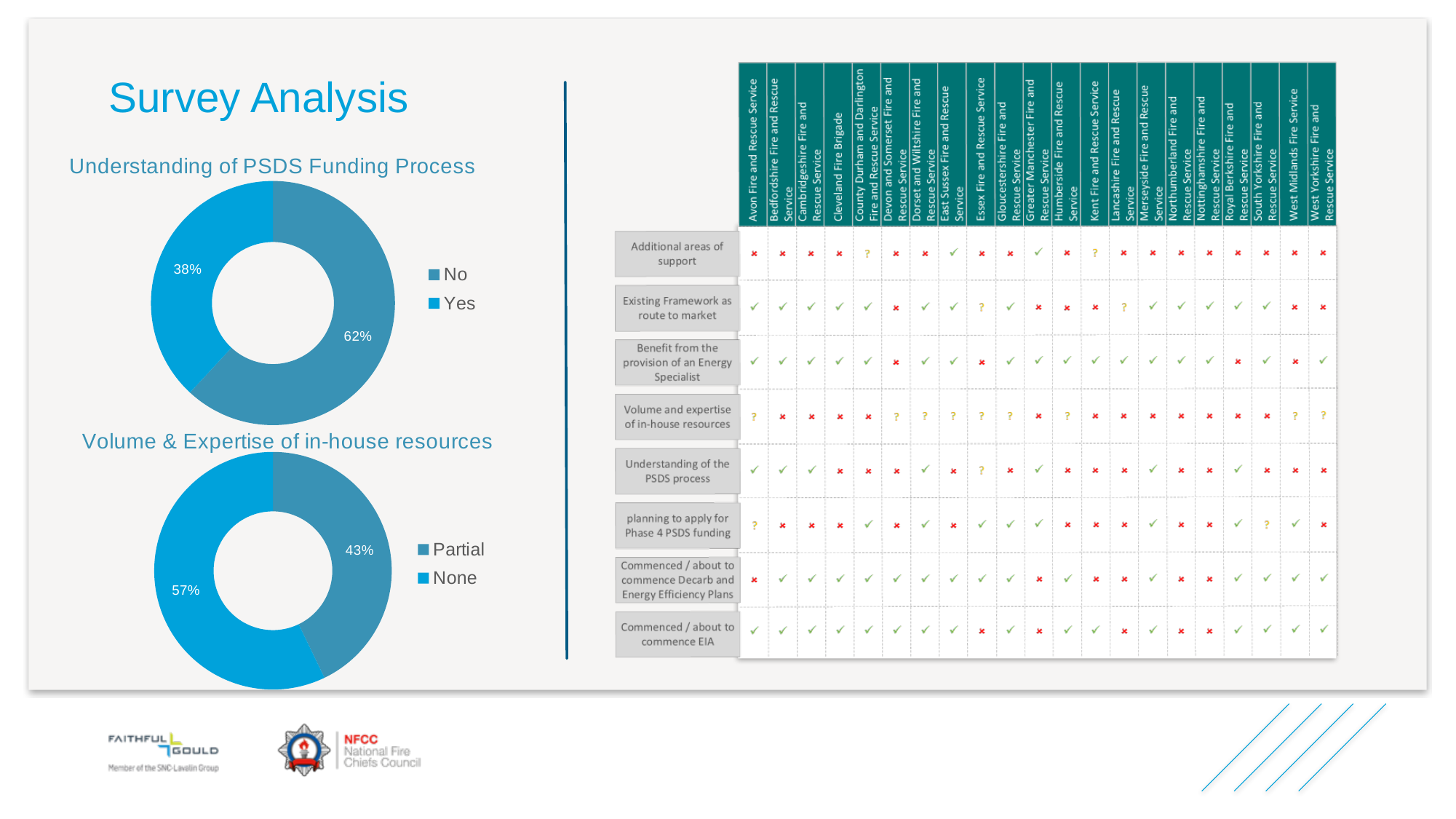
In the 'Volume & Expertise of in-house resources' chart, what is the difference between the 'None' and 'Partial' shares? 14% In the 'Understanding of PSDS Funding Process' chart, what is the smaller percentage shown? 38% What are the legend entries of the 'Understanding of PSDS Funding Process' chart? No, Yes In the 'Volume & Expertise of in-house resources' chart, what percentage is shown for 'None'? 57% How many slices does the 'Volume & Expertise of in-house resources' chart have? 2 How many categories does the legend of the 'Understanding of PSDS Funding Process' chart list? 2 In the 'Volume & Expertise of in-house resources' chart, what percentage is shown for 'Partial'? 43% In the 'Volume & Expertise of in-house resources' chart, which category has the larger share, 'Partial' or 'None'? None What are the legend entries of the 'Volume & Expertise of in-house resources' chart? Partial, None What kind of chart is used for 'Understanding of PSDS Funding Process'? Doughnut (pie) chart In the 'Understanding of PSDS Funding Process' chart, what is the difference between the two percentages? 24% In the 'Understanding of PSDS Funding Process' chart, what is the larger percentage shown? 62%